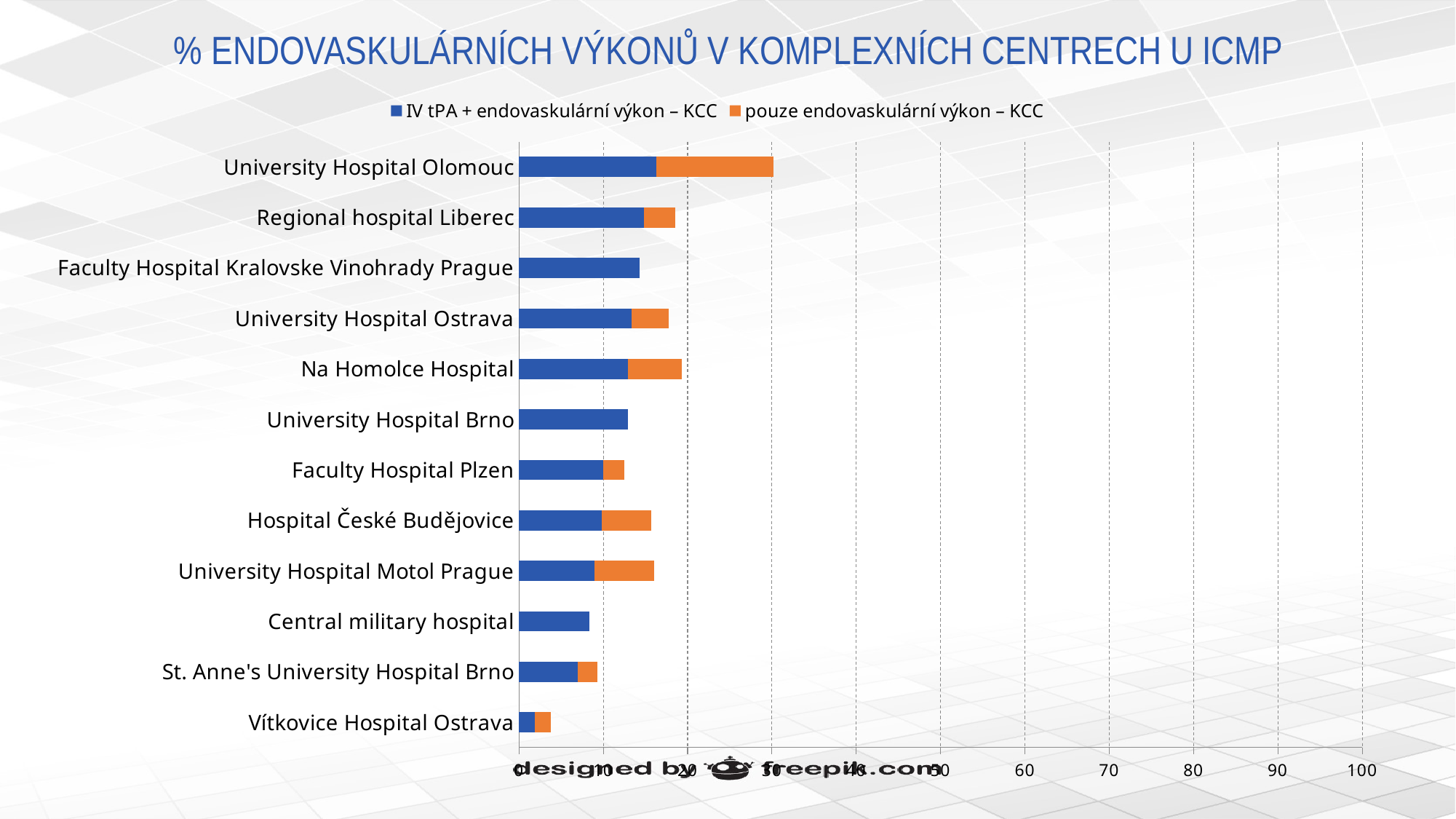
Is the total bar for Regional hospital Liberec greater or less than 10? greater Is the total bar for Central military hospital greater or less than 10? less Which colour represents the series 'pouze endovaskulární výkon – KCC'? orange Is the total bar for University Hospital Olomouc greater or less than 20? greater Which hospital has the shortest total bar? Vítkovice Hospital Ostrava What kind of chart is shown on the slide? bar chart How many series does the legend list? 2 How many hospitals are listed on the chart? 12 Which has a longer total bar, University Hospital Olomouc or Regional hospital Liberec? University Hospital Olomouc Which hospital has the longest total bar? University Hospital Olomouc What is the title of the chart? % ENDOVASKULÁRNÍCH VÝKONŮ V KOMPLEXNÍCH CENTRECH U ICMP